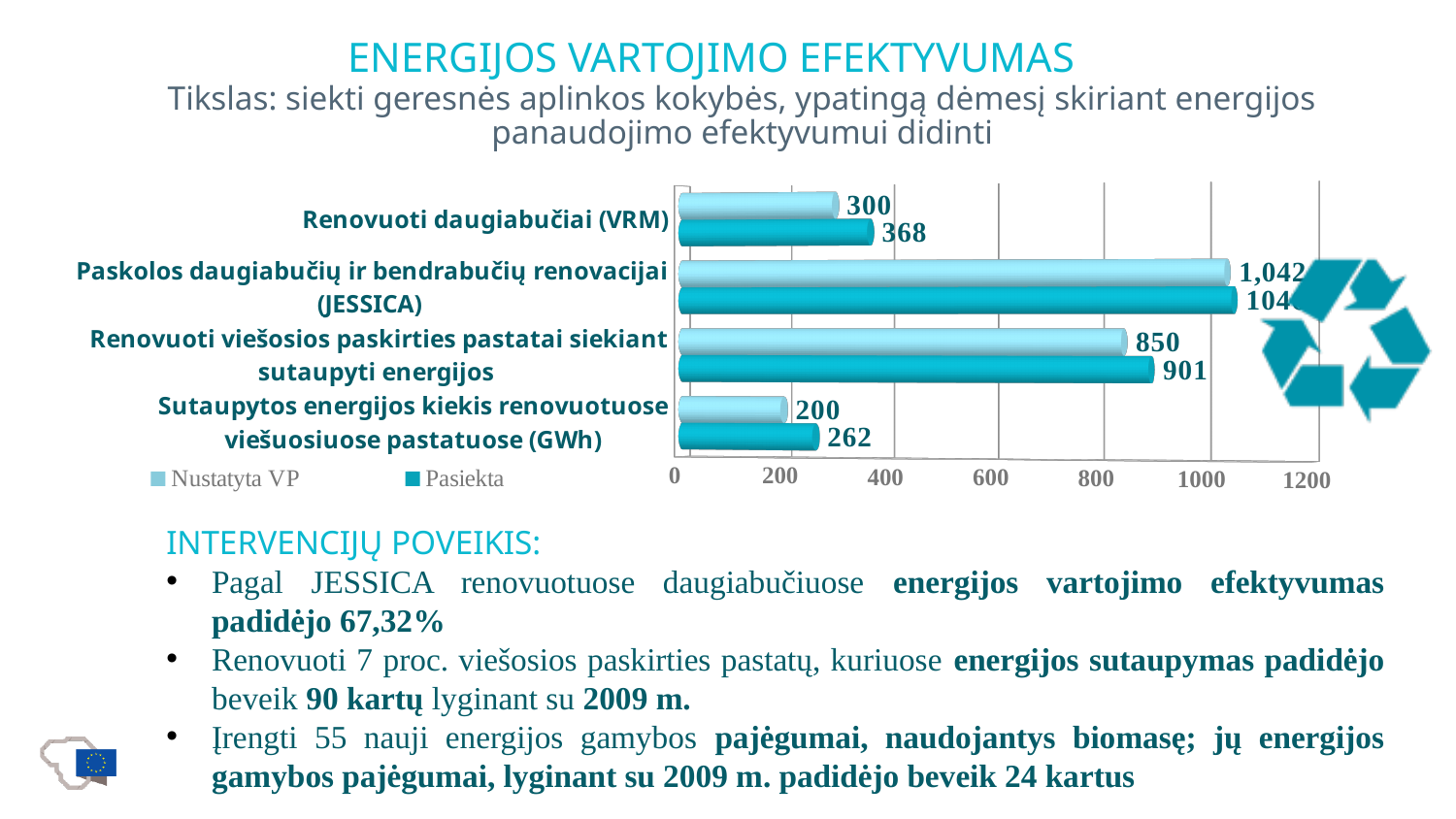
What kind of chart is shown on the slide? bar chart What is the Pasiekta value for Renovuoti viešosios paskirties pastatai siekiant sutaupyti energijos? 901 What is the difference between the Pasiekta and Nustatyta VP values for Renovuoti viešosios paskirties pastatai siekiant sutaupyti energijos? 51 How many series does the chart legend list? 2 Which category has the highest Nustatyta VP value? Paskolos daugiabučių ir bendrabučių renovacijai (JESSICA) Is the Pasiekta value for Paskolos daugiabučių ir bendrabučių renovacijai (JESSICA) greater or less than 1000? greater What is the Pasiekta value for Renovuoti daugiabučiai (VRM)? 368 What is the Nustatyta VP value for Renovuoti daugiabučiai (VRM)? 300 How many categories are shown on the chart? 4 What is the Nustatyta VP value for Sutaupytos energijos kiekis renovuotuose viešuosiuose pastatuose (GWh)? 200 Which category has the lowest Pasiekta value? Sutaupytos energijos kiekis renovuotuose viešuosiuose pastatuose (GWh) What is the Nustatyta VP value for Paskolos daugiabučių ir bendrabučių renovacijai (JESSICA)? 1,042